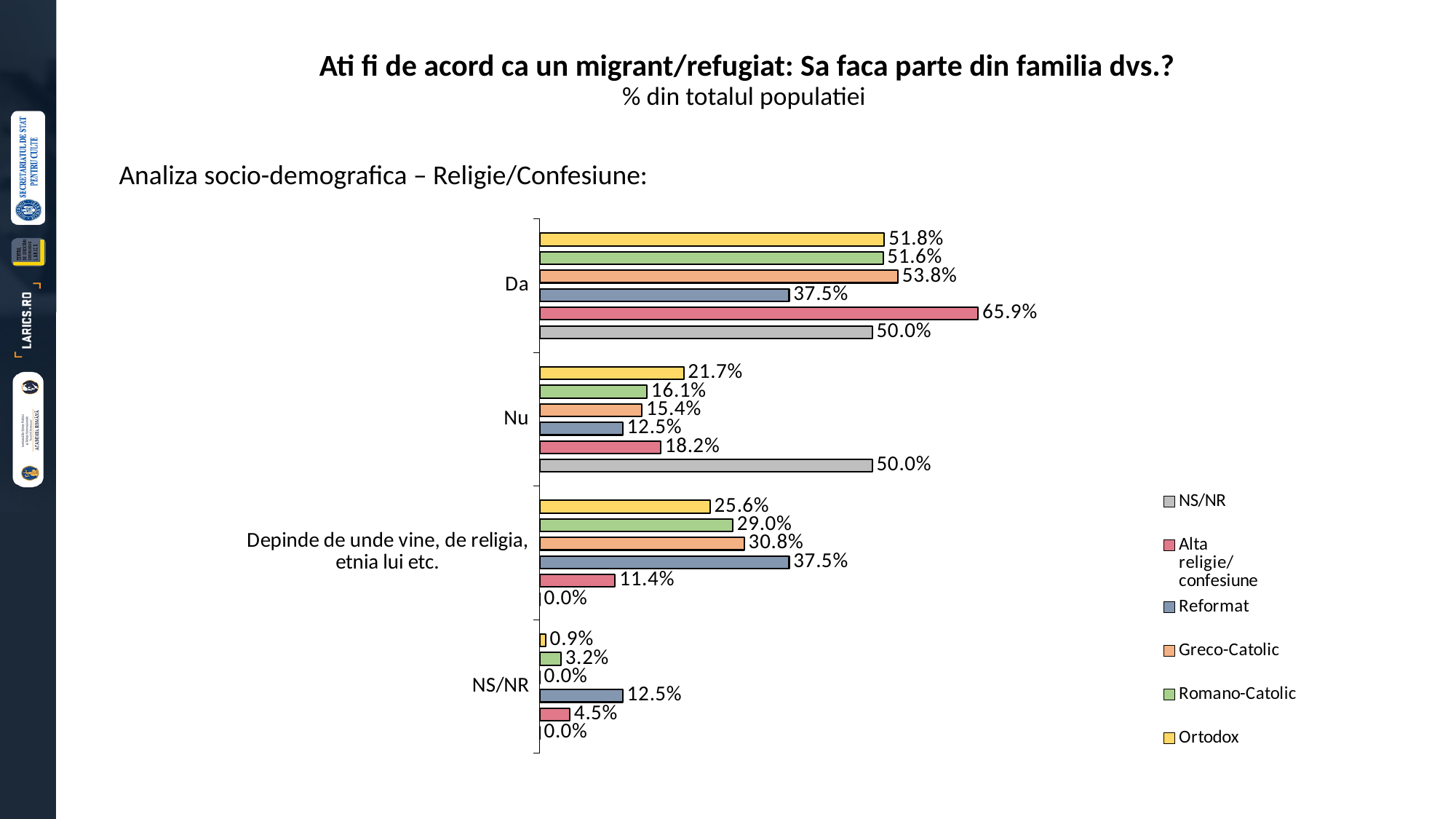
Which series has the lowest value in the 'Nu' category? Reformat In the 'Nu' category, which is larger: the value for Ortodox or the value for Greco-Catolic? Ortodox What is the value for Ortodox in the 'Da' category? 51.8% How many response categories are shown on the vertical axis? 4 What kind of chart is shown on the slide? Bar chart How many series does the legend list? 6 What is the subtitle shown under the chart title? % din totalul populatiei Which series has the highest value in the 'Da' category? Alta religie/confesiune What is the value for Reformat in the 'Depinde de unde vine, de religia, etnia lui etc.' category? 37.5% What is the value for Alta religie/confesiune in the 'Da' category? 65.9% What is the value for Romano-Catolic in the 'NS/NR' category? 3.2% What is the difference between the Alta religie/confesiune and Reformat values in the 'Da' category? 28.4%